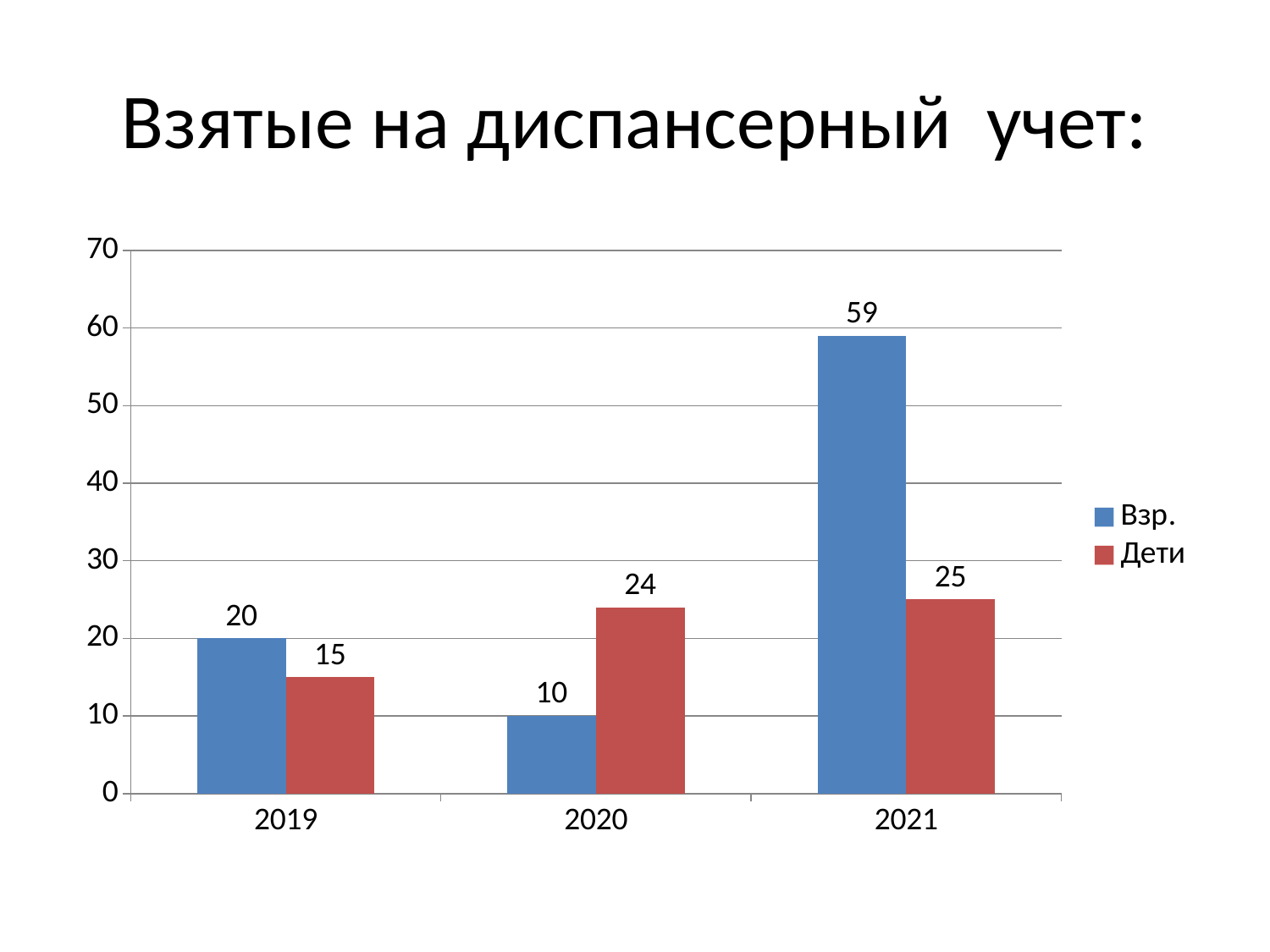
In which year is the value for Взр. highest? 2021 Does the value for Дети rise or fall from 2019 to 2021? Rise Which is larger in 2020, Взр. or Дети? Дети In which year is the value for Дети lowest? 2019 What is the difference between Взр. and Дети in 2021? 34 What is the title of the slide? Взятые на диспансерный учет: What kind of chart is shown on the slide? Bar chart How many years are shown on the x axis? 3 What is the value for Взр. in 2019? 20 What is the value for Дети in 2020? 24 What is the value for Взр. in 2021? 59 How many series does the legend list? 2